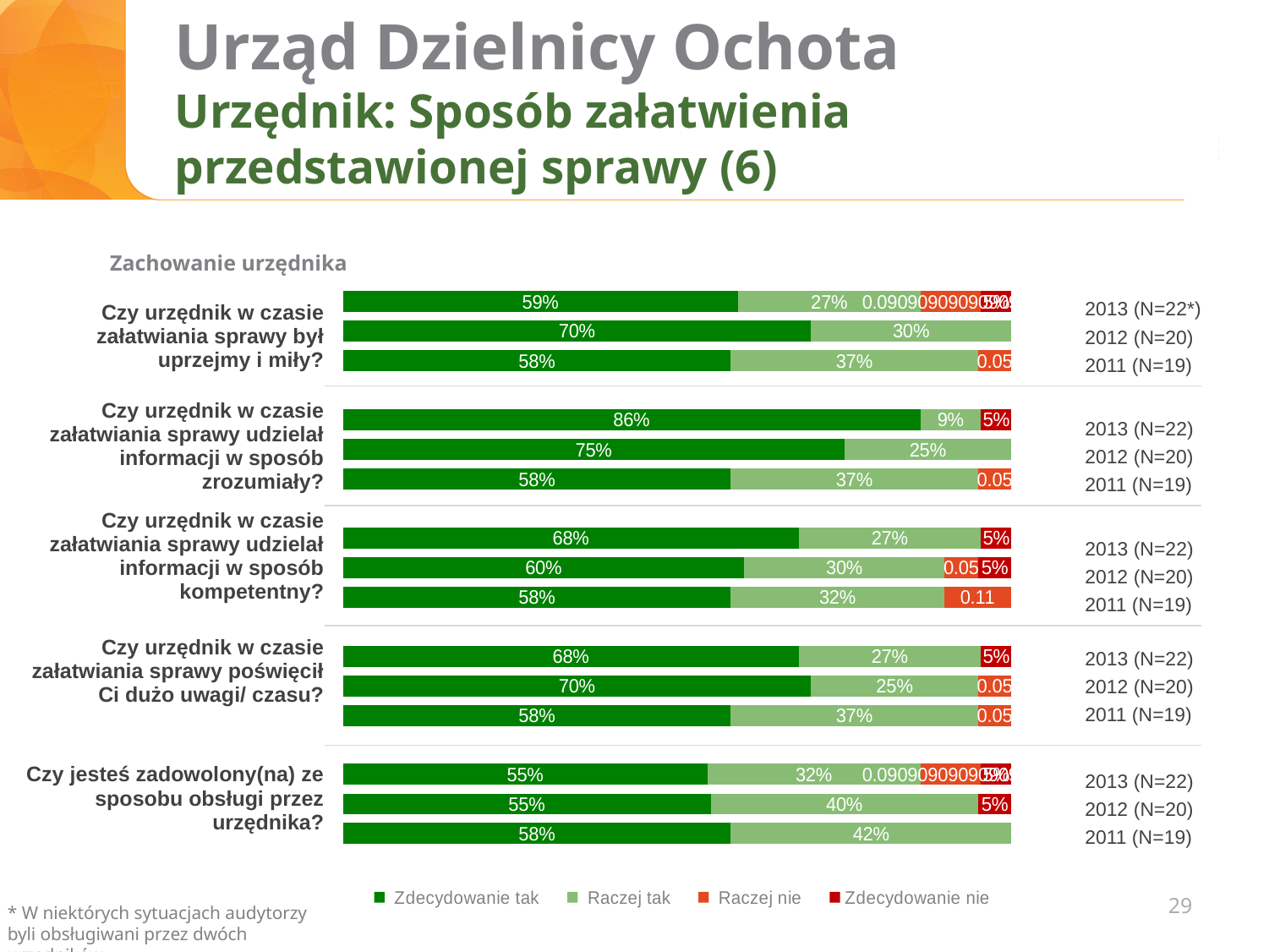
What percentage answered "Zdecydowanie tak" in 2012 to the question "Czy urzędnik w czasie załatwiania sprawy był uprzejmy i miły?" 70% For the question "Czy urzędnik w czasie załatwiania sprawy udzielał informacji w sposób kompetentny?", which year had the larger "Zdecydowanie tak" share, 2013 or 2012? 2013 For the question "Czy urzędnik w czasie załatwiania sprawy udzielał informacji w sposób zrozumiały?", what is the difference in percentage points between the "Zdecydowanie tak" share in 2012 and in 2011? 17 percentage points For the question "Czy urzędnik w czasie załatwiania sprawy udzielał informacji w sposób zrozumiały?", did the "Zdecydowanie tak" share rise or fall from 2011 to 2013? Rise What percentage answered "Raczej tak" in 2011 to the question "Czy jesteś zadowolony(na) ze sposobu obsługi przez urzędnika?" 42% How many response categories does the legend list? 4 Which colour represents "Zdecydowanie nie" in the legend? Dark red How many survey questions are shown in the chart? 5 What percentage answered "Zdecydowanie tak" in 2013 to the question "Czy urzędnik w czasie załatwiania sprawy udzielał informacji w sposób zrozumiały?" 86% What type of chart is shown on the slide? Stacked horizontal bar chart What percentage answered "Raczej tak" in 2012 to the question "Czy jesteś zadowolony(na) ze sposobu obsługi przez urzędnika?" 40% Across all questions and years, which bar has the highest "Zdecydowanie tak" share? 2013, "Czy urzędnik w czasie załatwiania sprawy udzielał informacji w sposób zrozumiały?" (86%)